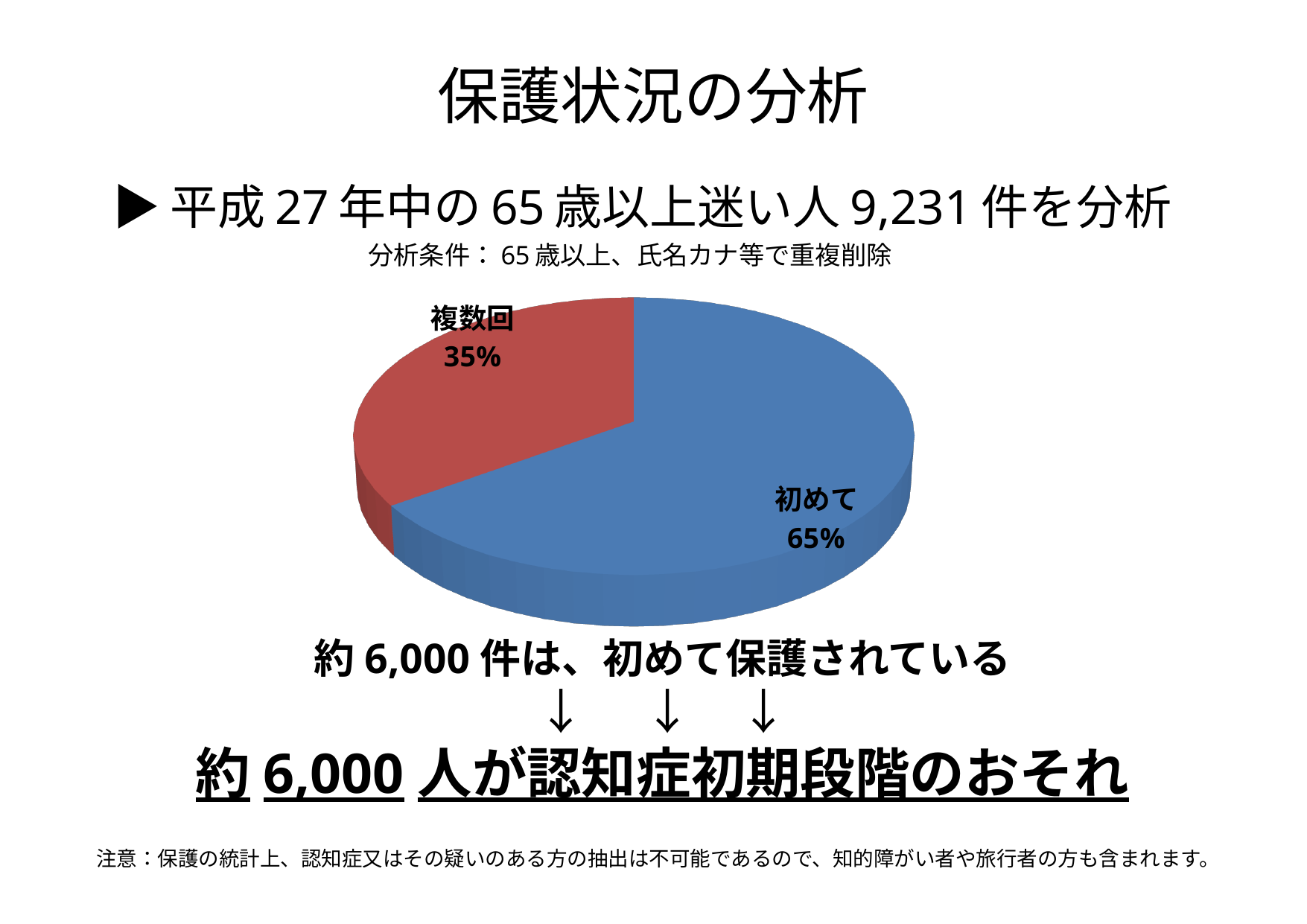
What colour is the 初めて slice? blue What colour is the 複数回 slice? red What share of the pie does 初めて represent? 65% What share of the pie does 複数回 represent? 35% Is the share for 複数回 greater or less than 50%? less What is the difference in percentage points between the 初めて and 複数回 slices? 30 Which slice of the pie is the smallest? 複数回 Which is larger, the 初めて slice or the 複数回 slice? 初めて How many slices does the pie chart have? 2 Which slice of the pie is the largest? 初めて What kind of chart is shown on the slide? pie chart Is the share for 初めて greater or less than 50%? greater